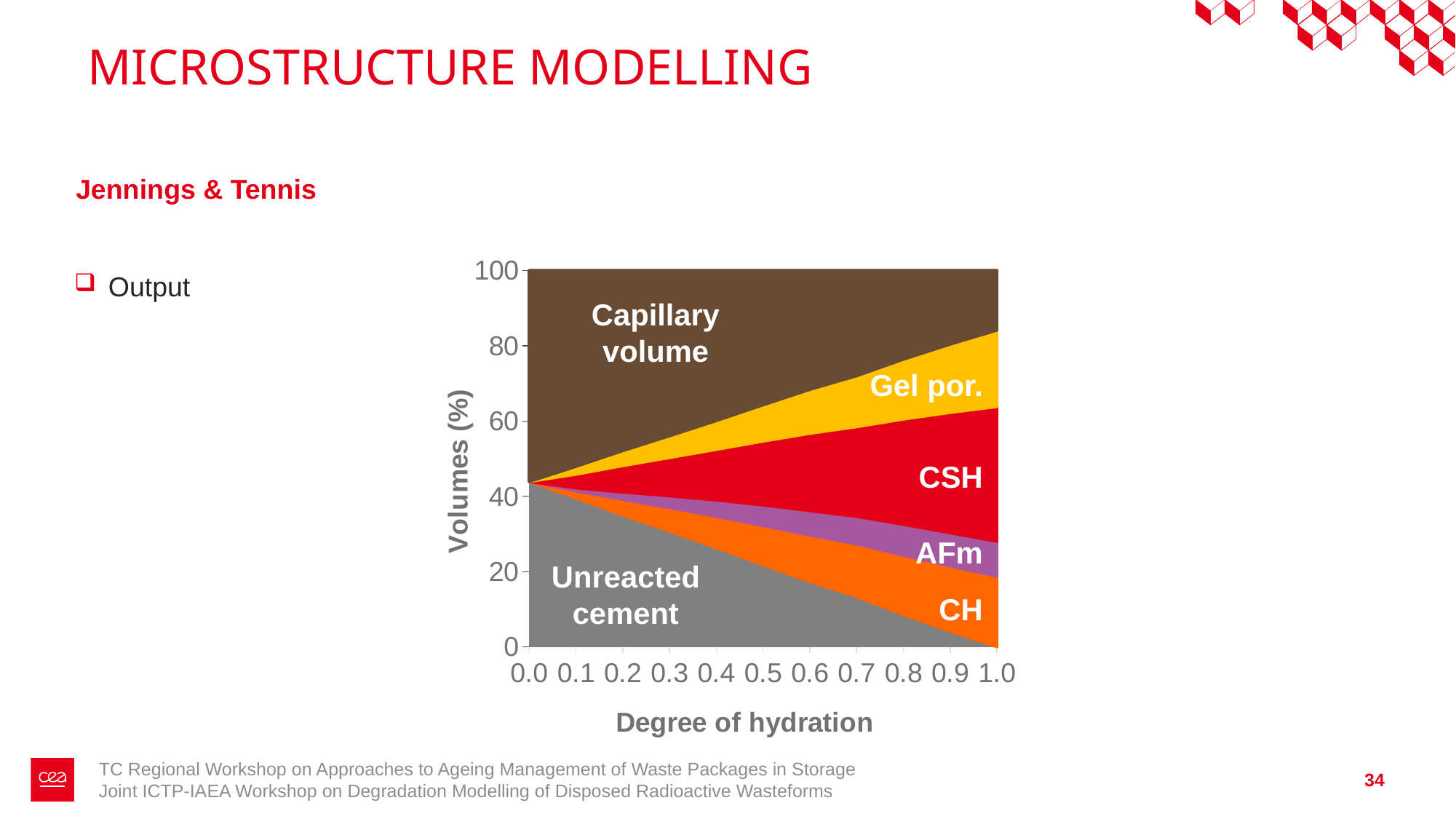
Is the volume of unreacted cement at a degree of hydration of 0.0 greater or less than 40%? greater What kind of chart is shown on the slide? Stacked area chart Does the volume of CSH rise or fall as the degree of hydration increases? Rise What is the title of the x axis? Degree of hydration Which region occupies the smallest volume at a degree of hydration of 1.0? Unreacted cement Does the volume of unreacted cement rise or fall as the degree of hydration increases? Fall Which region occupies the largest volume at a degree of hydration of 0.0? Capillary volume At a degree of hydration of 0.0, which is larger: the capillary volume or the unreacted cement volume? Capillary volume Is the capillary volume at a degree of hydration of 1.0 greater or less than 20%? less Which region occupies the largest volume at a degree of hydration of 1.0? CSH How many labelled regions (series) does the chart show? 6 What is the title of the y axis? Volumes (%)